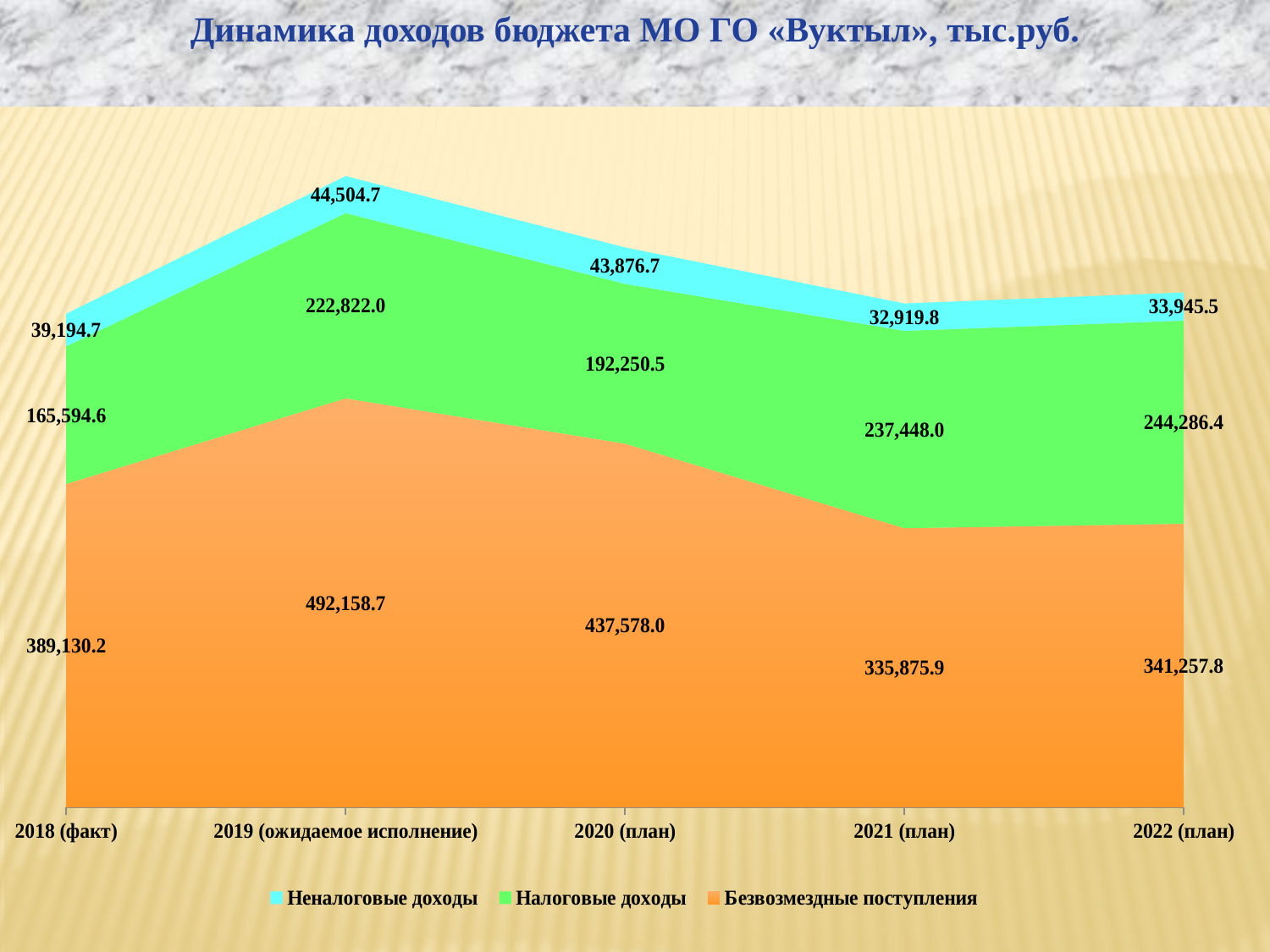
What is the value of Налоговые доходы for 2022 (план)? 244,286.4 What kind of chart is shown on the slide? Stacked area chart Which is larger: Безвозмездные поступления in 2020 (план) or in 2021 (план)? 2020 (план) In which year is Неналоговые доходы the lowest? 2021 (план) What is the value of Безвозмездные поступления for 2019 (ожидаемое исполнение)? 492,158.7 In which year is Безвозмездные поступления the highest? 2019 (ожидаемое исполнение) What is the total of all three series for 2018 (факт)? 593,919.5 How many years (categories) are shown on the x axis? 5 Which series is shown in orange in the legend? Безвозмездные поступления What is the difference between Налоговые доходы in 2022 (план) and 2018 (факт)? 78,691.8 What is the value of Неналоговые доходы for 2018 (факт)? 39,194.7 How many series does the legend list? 3